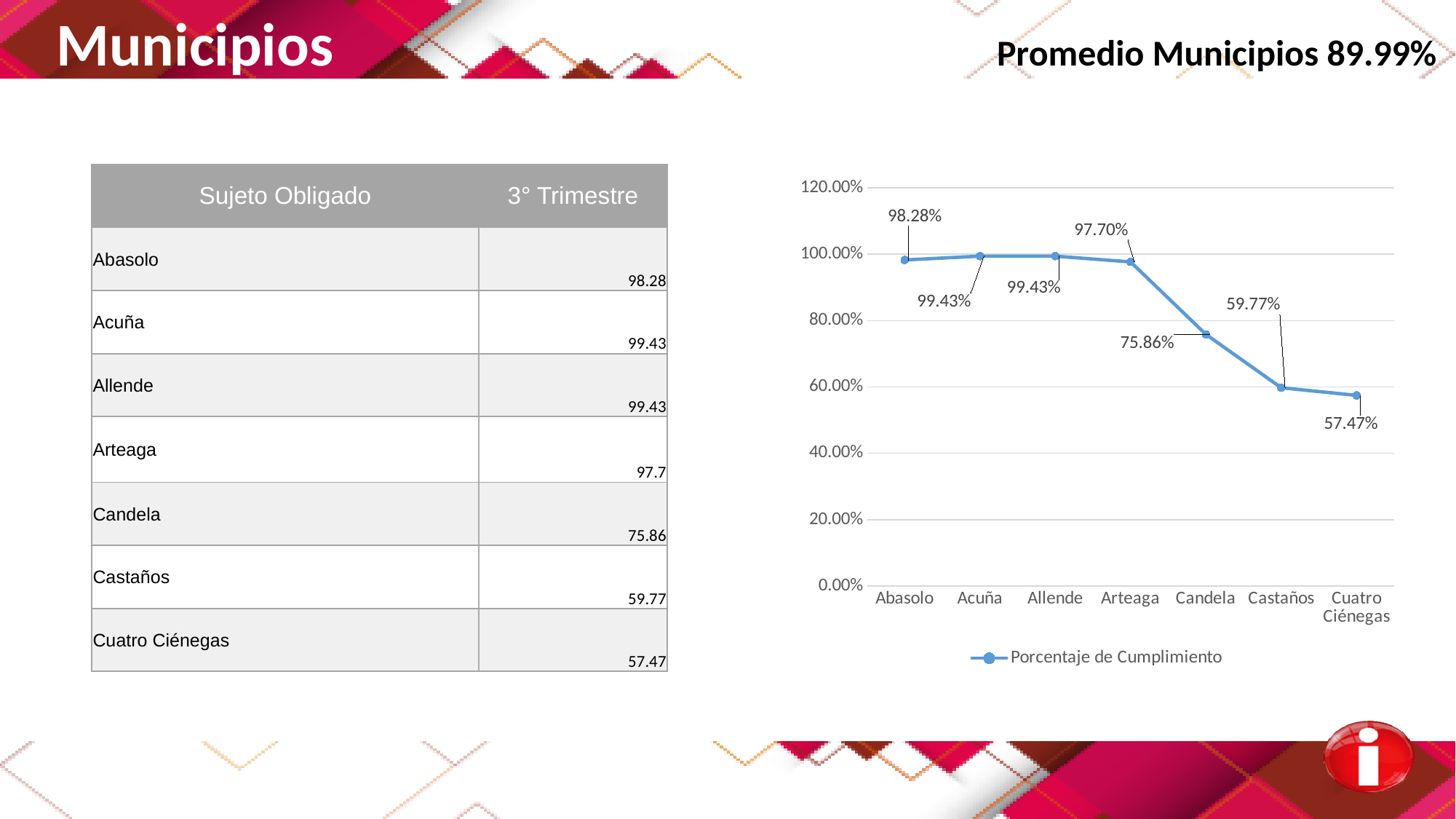
Which municipality has the lowest value in the chart? Cuatro Ciénegas Is the value for Castaños greater or less than 80.00%? less What kind of chart is shown on the slide? line chart How many series does the chart legend list? 1 Do the values generally rise or fall from Abasolo to Cuatro Ciénegas along the x axis? fall What is the value for Cuatro Ciénegas in the chart? 57.47% What is the value for Abasolo in the chart? 98.28% Which is larger, the value for Candela or the value for Castaños? Candela What is the difference between the values for Candela and Castaños? 16.09% What is the value for Candela in the chart? 75.86% What is the value for Arteaga in the chart? 97.70% How many municipalities are plotted on the x axis of the chart? 7